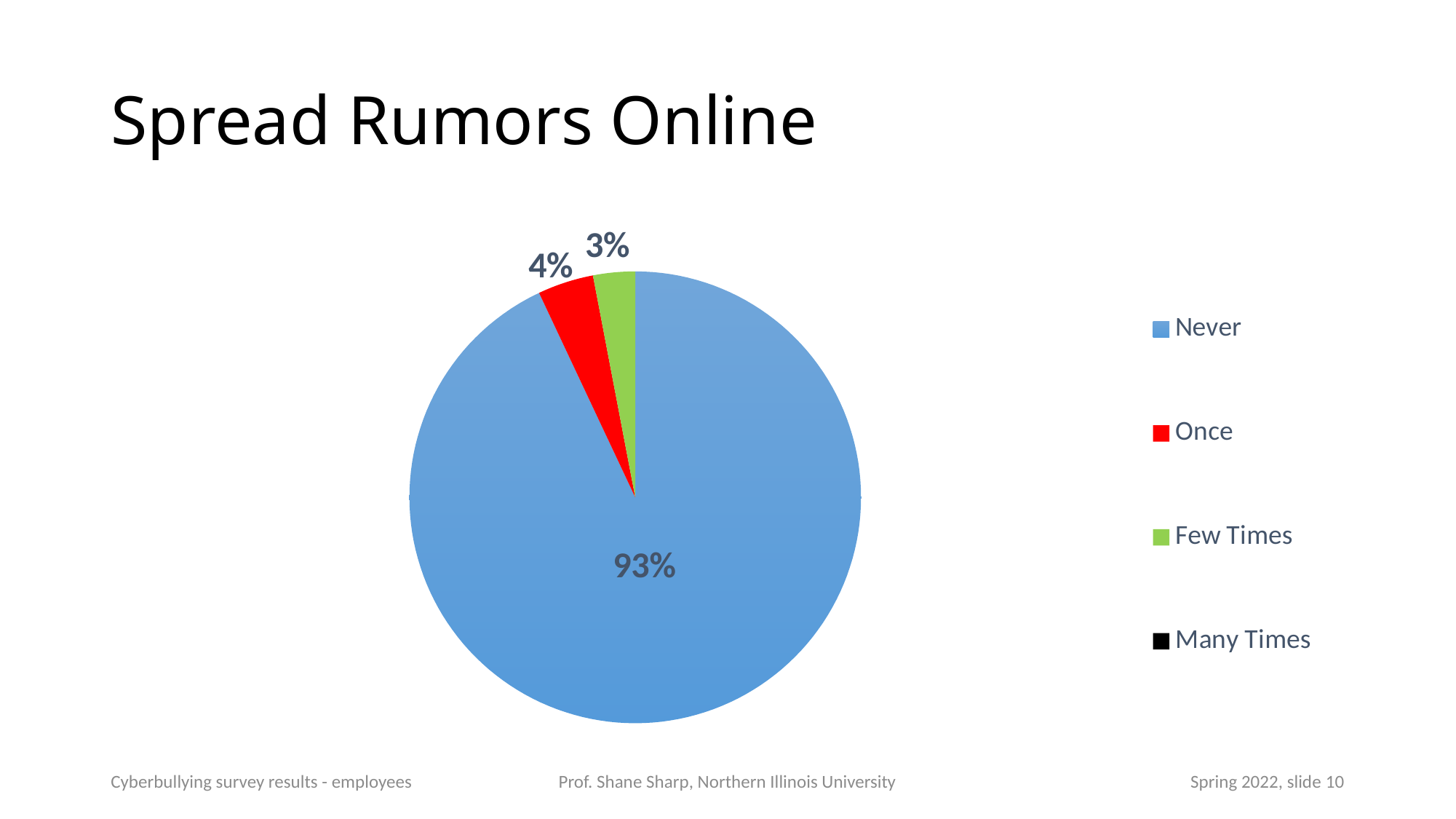
Which category has the largest slice of the pie? Never What is the title of the slide containing the chart? Spread Rumors Online How many entries does the legend list? 4 What is the difference between the Never slice and the Once slice? 89% What percentage is shown for the Once slice? 4% What is the difference between the Once slice and the Few Times slice? 1% Which is larger, the Once slice or the Few Times slice? Once What percentage is shown for the Few Times slice? 3% What colour is the Never slice in the pie chart? Blue What share of the pie does the Never slice represent? 93% What kind of chart is shown on the slide? Pie chart What percentage of the pie is labelled for the Never slice? 93%